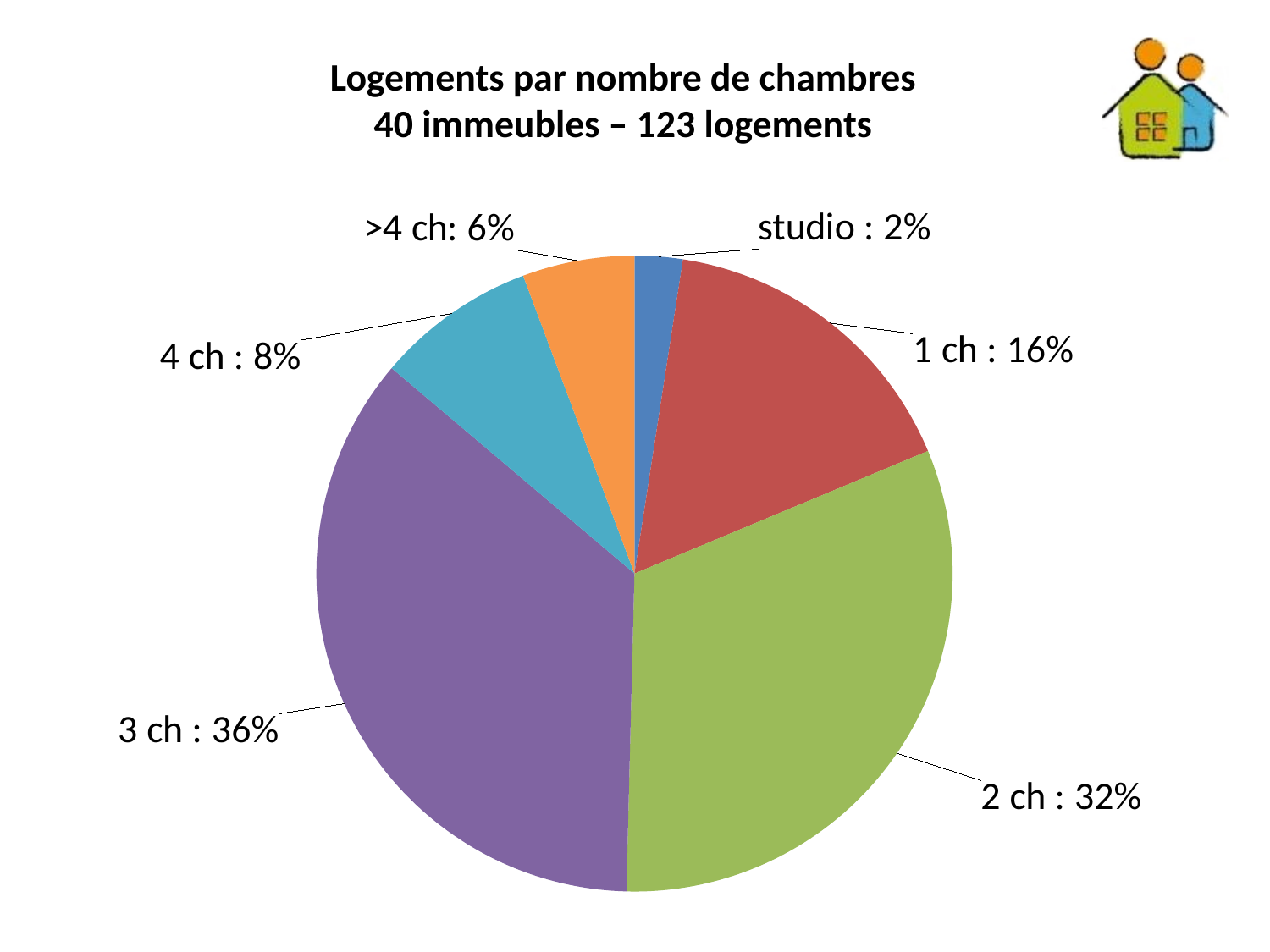
What is the title of the chart? Logements par nombre de chambres 40 immeubles – 123 logements Which is larger, the share for "4 ch" or the share for ">4 ch"? 4 ch Which category has the largest slice of the pie? 3 ch What share of the pie does the "studio" slice represent? 2% How many slices does the pie chart have? 6 What share of the pie does the "3 ch" slice represent? 36% What kind of chart is shown on the slide? pie chart What is the value shown for "1 ch"? 16% What is the difference between the shares of "3 ch" and "2 ch"? 4% What is the value shown for "4 ch"? 8% What is the difference between the shares of "1 ch" and ">4 ch"? 10% Which category has the smallest slice of the pie? studio